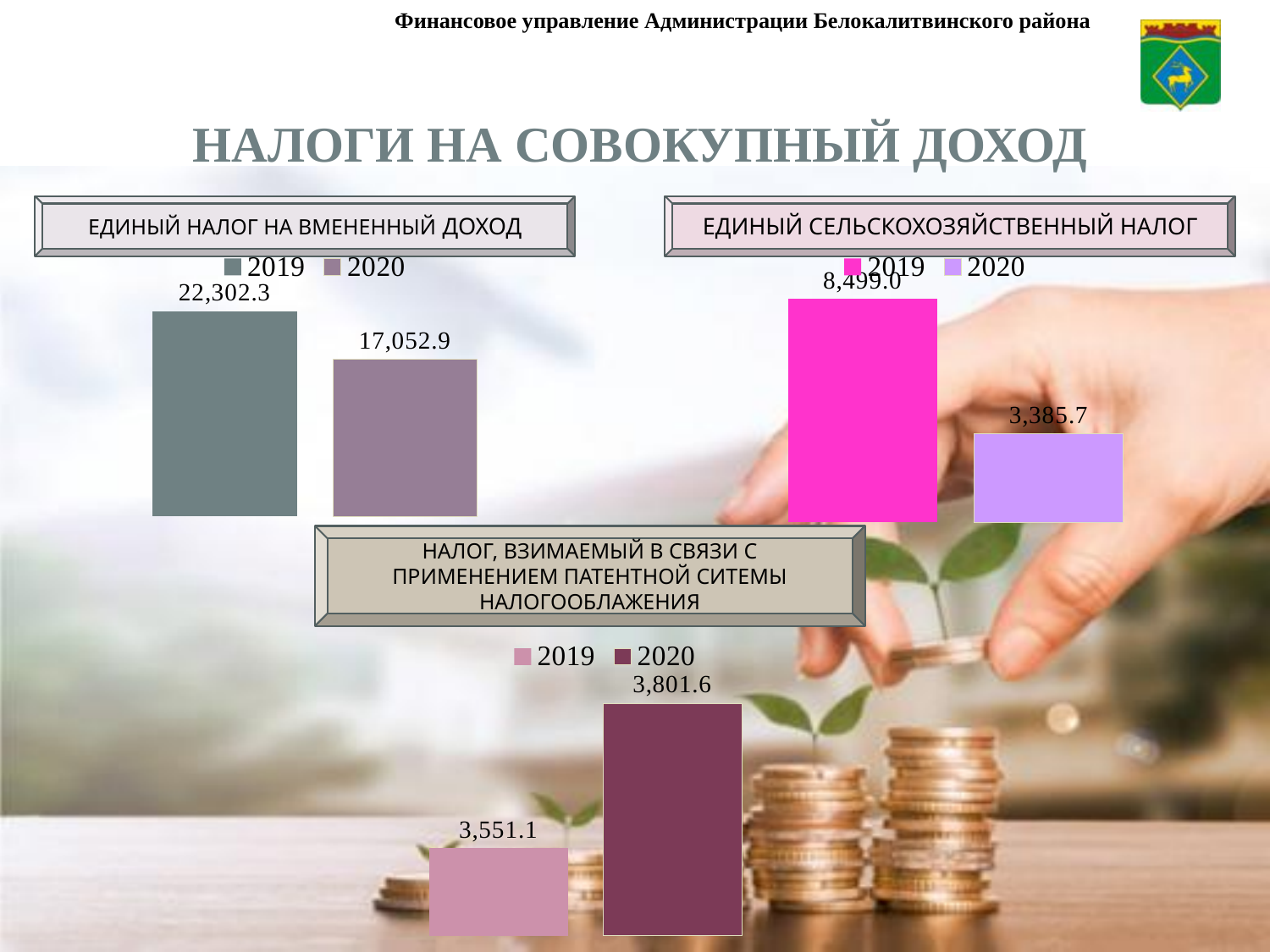
In the chart titled "НАЛОГ, ВЗИМАЕМЫЙ В СВЯЗИ С ПРИМЕНЕНИЕМ ПАТЕНТНОЙ СИТЕМЫ НАЛОГООБЛАЖЕНИЯ", what is the value for 2020? 3,801.6 In the chart titled "ЕДИНЫЙ СЕЛЬСКОХОЗЯЙСТВЕННЫЙ НАЛОГ", what is the value for 2020? 3,385.7 In the chart titled "ЕДИНЫЙ НАЛОГ НА ВМЕНЕННЫЙ ДОХОД", what is the value for 2019? 22,302.3 In the chart titled "НАЛОГ, ВЗИМАЕМЫЙ В СВЯЗИ С ПРИМЕНЕНИЕМ ПАТЕНТНОЙ СИТЕМЫ НАЛОГООБЛАЖЕНИЯ", which year has the larger value, 2019 or 2020? 2020 How many series does the legend of the chart titled "ЕДИНЫЙ НАЛОГ НА ВМЕНЕННЫЙ ДОХОД" list? 2 In the chart titled "ЕДИНЫЙ СЕЛЬСКОХОЗЯЙСТВЕННЫЙ НАЛОГ", what is the value for 2019? 8,499.0 In the chart titled "ЕДИНЫЙ НАЛОГ НА ВМЕНЕННЫЙ ДОХОД", what is the value for 2020? 17,052.9 In the chart titled "НАЛОГ, ВЗИМАЕМЫЙ В СВЯЗИ С ПРИМЕНЕНИЕМ ПАТЕНТНОЙ СИТЕМЫ НАЛОГООБЛАЖЕНИЯ", what is the difference between the 2020 and 2019 values? 250.5 In the chart titled "ЕДИНЫЙ НАЛОГ НА ВМЕНЕННЫЙ ДОХОД", what is the difference between the 2019 and 2020 values? 5,249.4 In the chart titled "ЕДИНЫЙ СЕЛЬСКОХОЗЯЙСТВЕННЫЙ НАЛОГ", which year has the higher value? 2019 In the chart titled "НАЛОГ, ВЗИМАЕМЫЙ В СВЯЗИ С ПРИМЕНЕНИЕМ ПАТЕНТНОЙ СИТЕМЫ НАЛОГООБЛАЖЕНИЯ", what is the value for 2019? 3,551.1 In the chart titled "ЕДИНЫЙ СЕЛЬСКОХОЗЯЙСТВЕННЫЙ НАЛОГ", by how much does the 2019 value exceed the 2020 value? 5,113.3